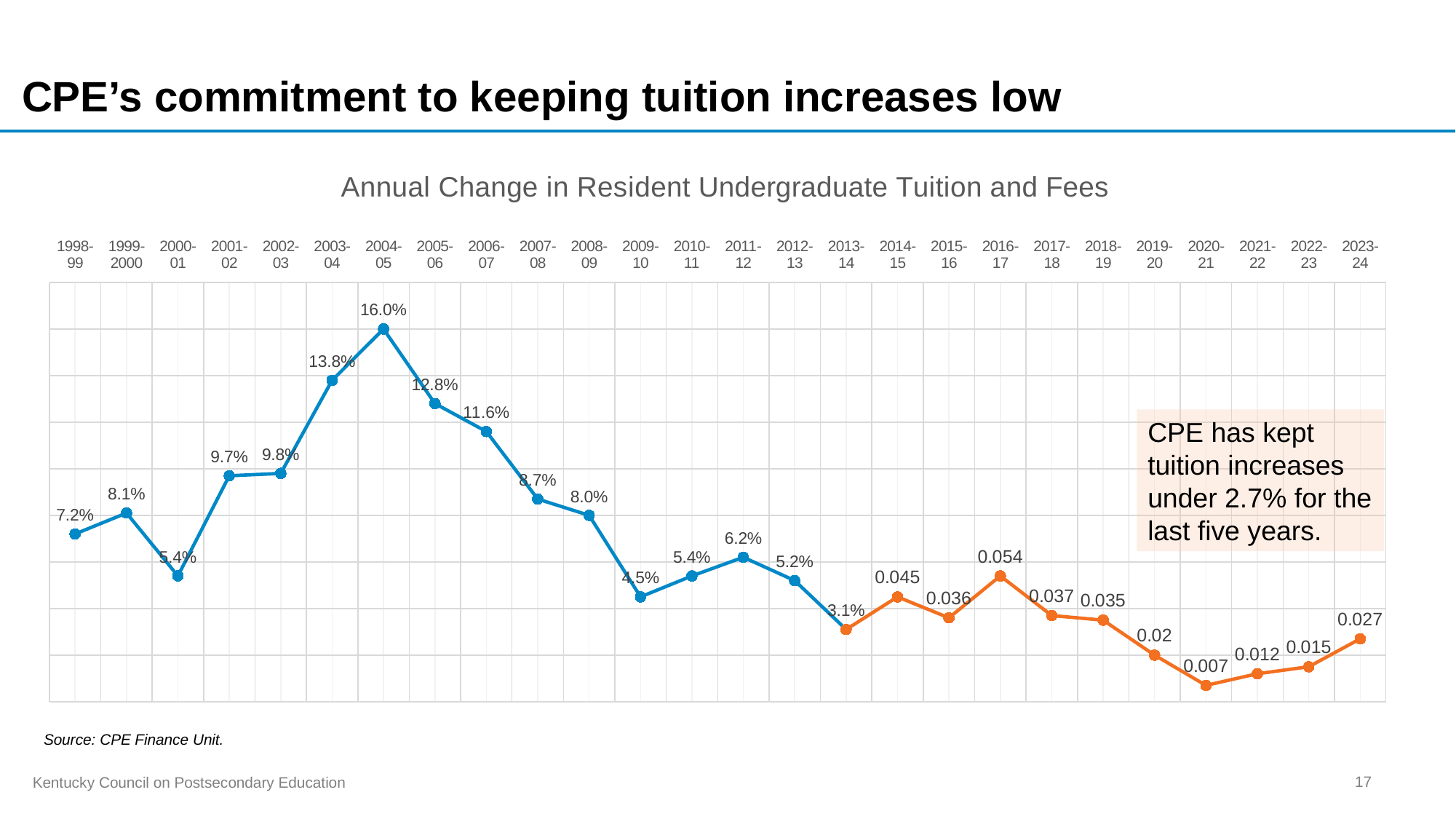
Which year has the highest annual change in tuition and fees? 2004-05 What is the annual change in tuition and fees for 2004-05? 16.0% What kind of chart is shown on the slide? Line chart Which year has the lowest annual change in tuition and fees? 2020-21 What is the value shown for 2016-17? 0.054 What is the chart's title? Annual Change in Resident Undergraduate Tuition and Fees What is the value shown for 2023-24? 0.027 How many academic years are plotted on the chart? 26 Which is larger, the value for 2005-06 or the value for 2006-07? 2005-06 What is the value shown for 2020-21? 0.007 Do the values generally rise or fall from 2004-05 to 2013-14? Fall What is the difference between the values for 2003-04 and 2004-05? 2.2 percentage points